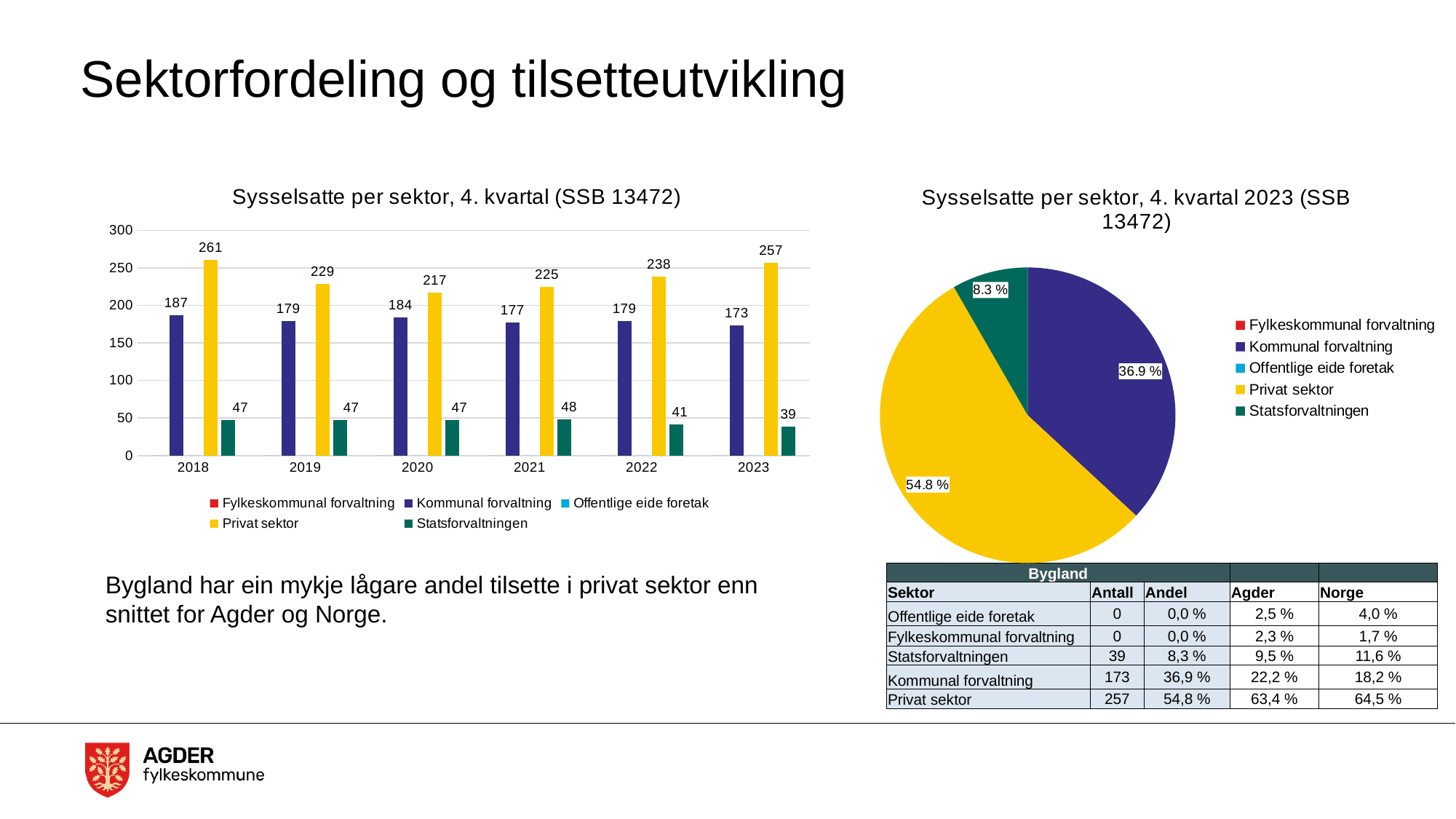
In the bar chart 'Sysselsatte per sektor, 4. kvartal (SSB 13472)', in which year is Kommunal forvaltning highest? 2018 In the pie chart 'Sysselsatte per sektor, 4. kvartal 2023 (SSB 13472)', what share does Privat sektor have? 54.8 % In the bar chart 'Sysselsatte per sektor, 4. kvartal (SSB 13472)', what is the difference between Privat sektor and Kommunal forvaltning in 2023? 84 In the bar chart 'Sysselsatte per sektor, 4. kvartal (SSB 13472)', what is the value for Privat sektor in 2018? 261 In the pie chart 'Sysselsatte per sektor, 4. kvartal 2023 (SSB 13472)', what share does Statsforvaltningen have? 8.3 % In the bar chart 'Sysselsatte per sektor, 4. kvartal (SSB 13472)', how many years are shown on the x axis? 6 In the bar chart 'Sysselsatte per sektor, 4. kvartal (SSB 13472)', which is larger in 2021: Privat sektor or Kommunal forvaltning? Privat sektor In the bar chart 'Sysselsatte per sektor, 4. kvartal (SSB 13472)', what is the value for Kommunal forvaltning in 2023? 173 In the bar chart 'Sysselsatte per sektor, 4. kvartal (SSB 13472)', what is the value for Statsforvaltningen in 2022? 41 In the bar chart 'Sysselsatte per sektor, 4. kvartal (SSB 13472)', in which year is Privat sektor lowest? 2020 In the bar chart 'Sysselsatte per sektor, 4. kvartal (SSB 13472)', how many series does the legend list? 5 What kind of chart is the chart on the left of the slide? Bar chart